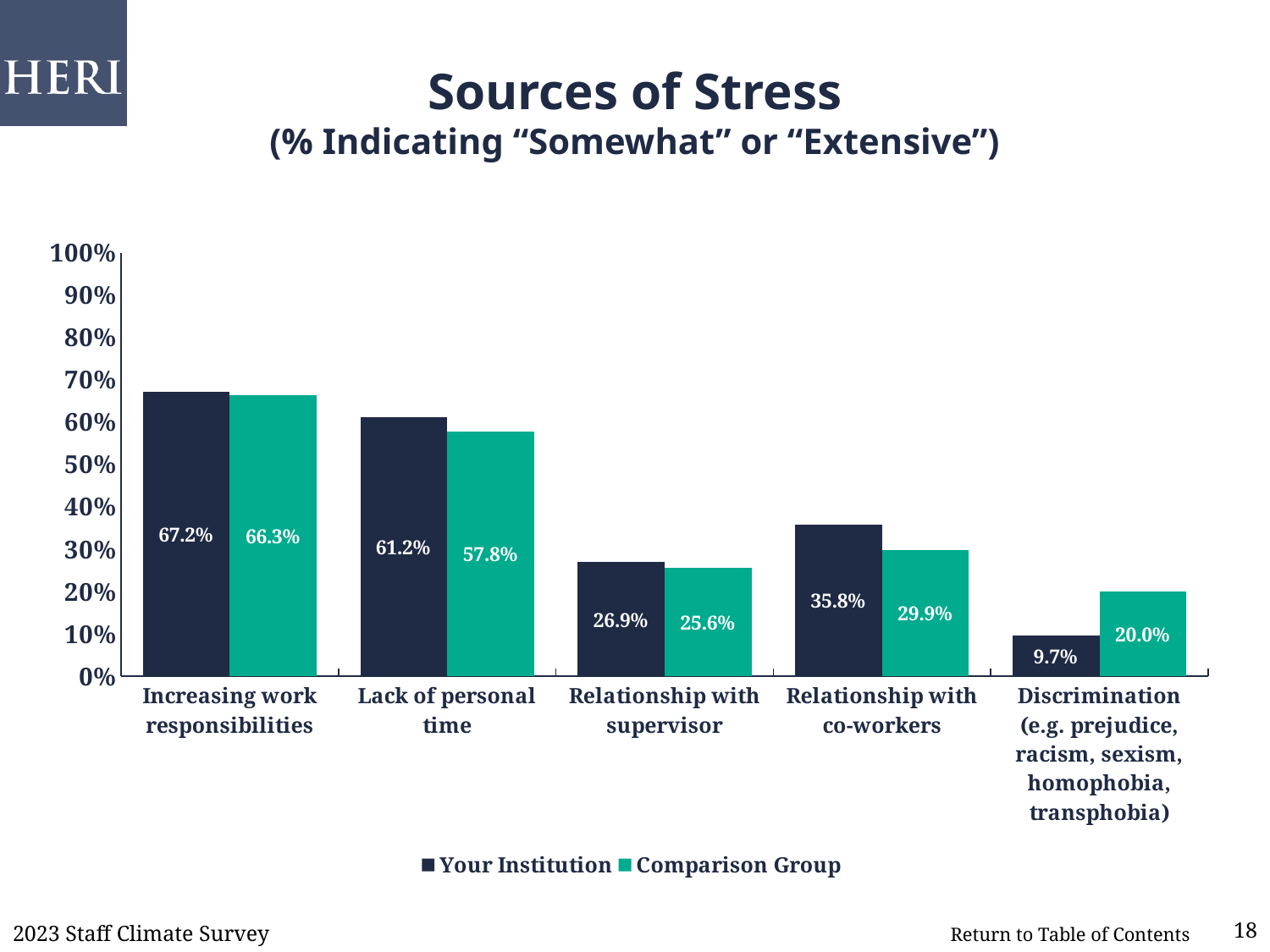
What is the value for Your Institution for Increasing work responsibilities? 67.2% Which category has the lowest value for Comparison Group? Discrimination (e.g. prejudice, racism, sexism, homophobia, transphobia) What is the value for Comparison Group for Lack of personal time? 57.8% How many series does the legend list? 2 What kind of chart is shown on the slide? bar chart Is the value for Your Institution for Relationship with supervisor greater or less than 30%? less Which category has the highest value for Your Institution? Increasing work responsibilities How many categories are shown on the x axis? 5 What is the subtitle of the chart? (% Indicating "Somewhat" or "Extensive") What is the difference between Your Institution and Comparison Group for Relationship with co-workers? 5.9% Which is larger for Discrimination: Your Institution or Comparison Group? Comparison Group What is the value for Your Institution for Discrimination (e.g. prejudice, racism, sexism, homophobia, transphobia)? 9.7%